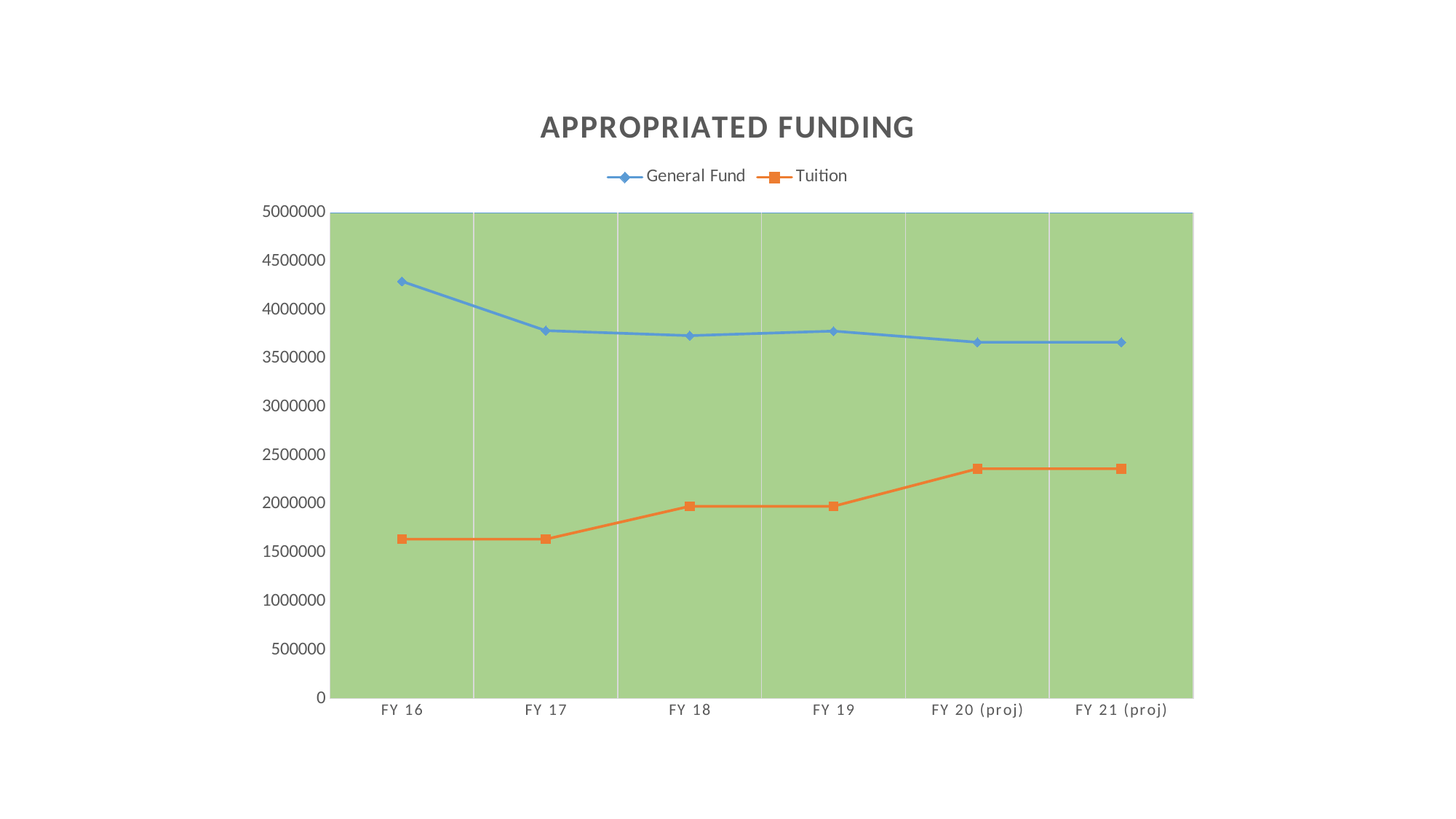
Is the Tuition value for FY 16 greater or less than 2000000? less Which colour is used for the Tuition series? Orange Is the General Fund value for FY 16 greater or less than 4000000? greater How many fiscal year categories are shown on the x axis? 6 In which fiscal year is the General Fund value highest? FY 16 Is the General Fund value for FY 20 (proj) greater or less than 3500000? greater How many series does the legend list? 2 Which series has the larger value in FY 18, General Fund or Tuition? General Fund What type of chart is shown on the slide? Line chart Does the Tuition series generally rise or fall from FY 16 to FY 21 (proj)? Rise What is the title of the chart? APPROPRIATED FUNDING